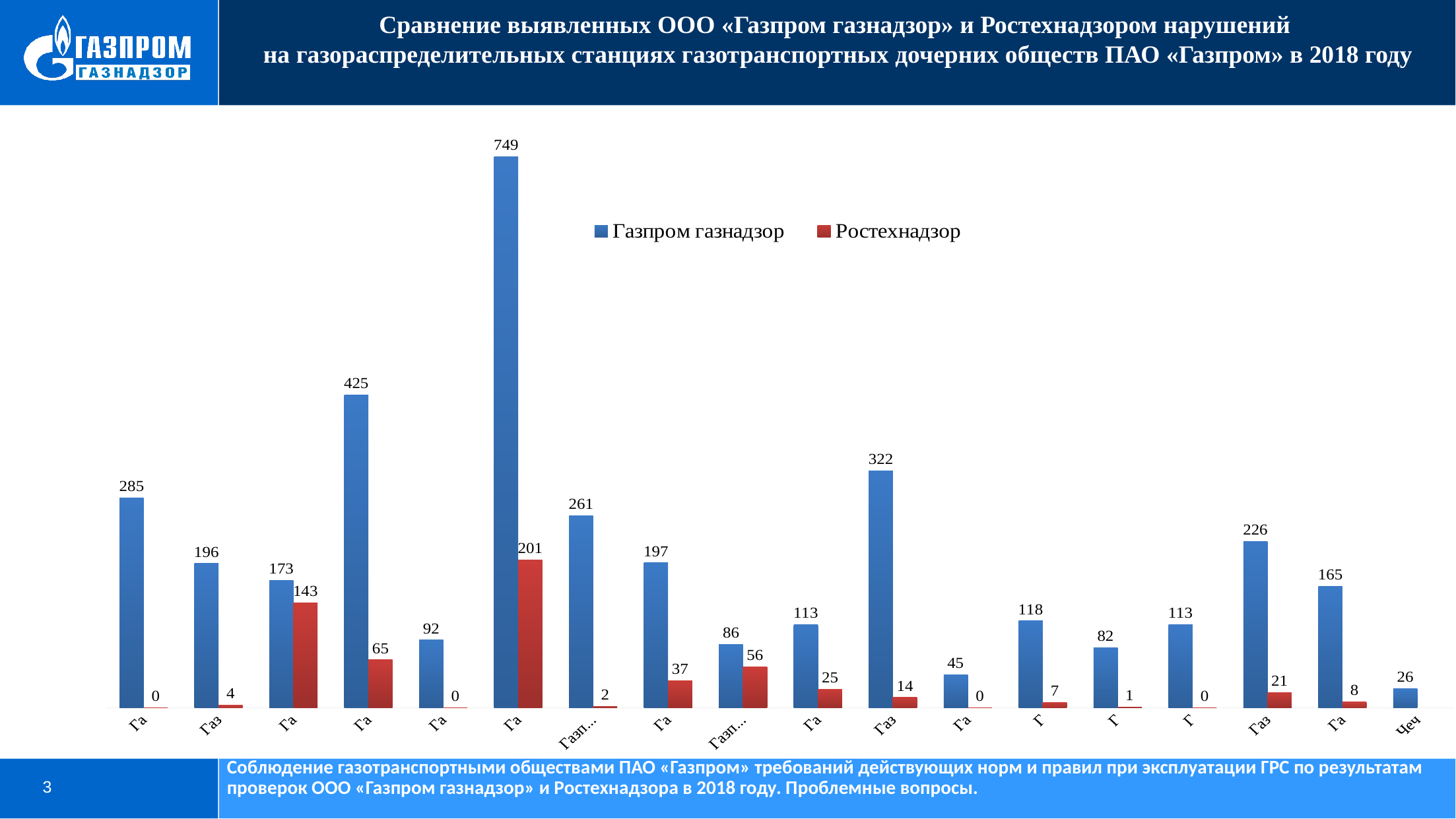
What is the highest value in the Газпром газнадзор series? 749 For the third category from the left, how much larger is the Газпром газнадзор value than the Ростехнадзор value? 30 What is the lowest value in the Газпром газнадзор series? 26 What kind of chart is shown on the slide? bar chart Which is larger in the Газпром газнадзор series: the first category from the left or the fourth category from the left? the fourth category What is the highest value in the Ростехнадзор series? 201 How many categories are plotted along the x axis? 18 What is the Газпром газнадзор value for the first category from the left? 285 For the sixth category from the left, what is the difference between the Газпром газнадзор value and the Ростехнадзор value? 548 What is the Ростехнадзор value for the third category from the left? 143 What are the two series named in the legend? Газпром газнадзор and Ростехнадзор How many series does the legend list? 2